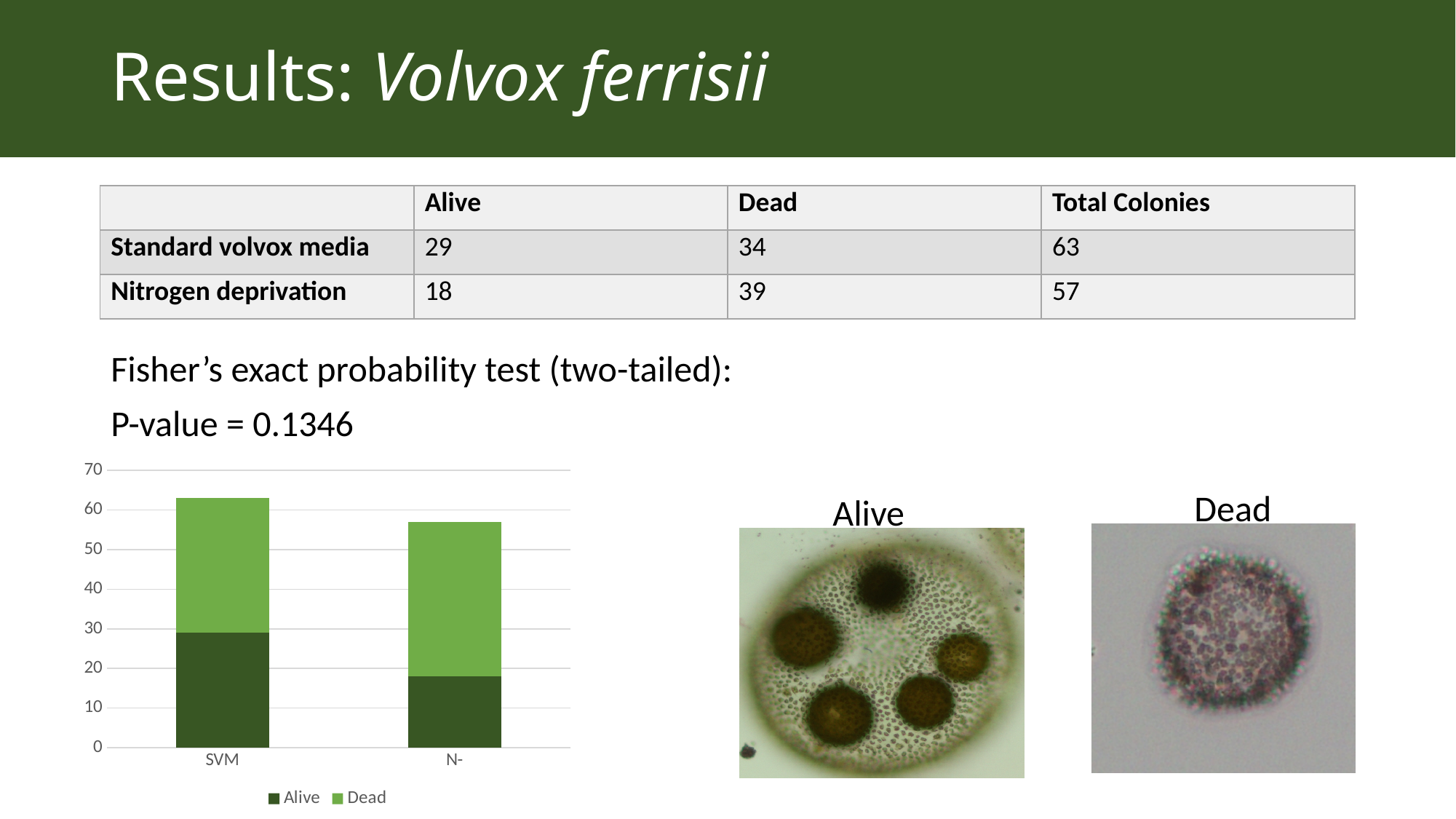
What kind of chart is shown on the slide? stacked bar chart How many series does the legend of the bar chart list? 2 Is the Alive value for SVM greater or less than 20? greater What is the total of the stacked bar for SVM (standard volvox media), as given in the table? 63 Is the Alive value for N- greater or less than 20? less Which category has the taller stacked bar, SVM or N-? SVM Which category has the larger Alive segment in the bar chart? SVM Is the total height of the N- bar greater or less than 60? less Which series are listed in the legend of the bar chart? Alive, Dead Which category has the larger Dead segment in the bar chart? N- How many categories are shown on the x axis of the bar chart? 2